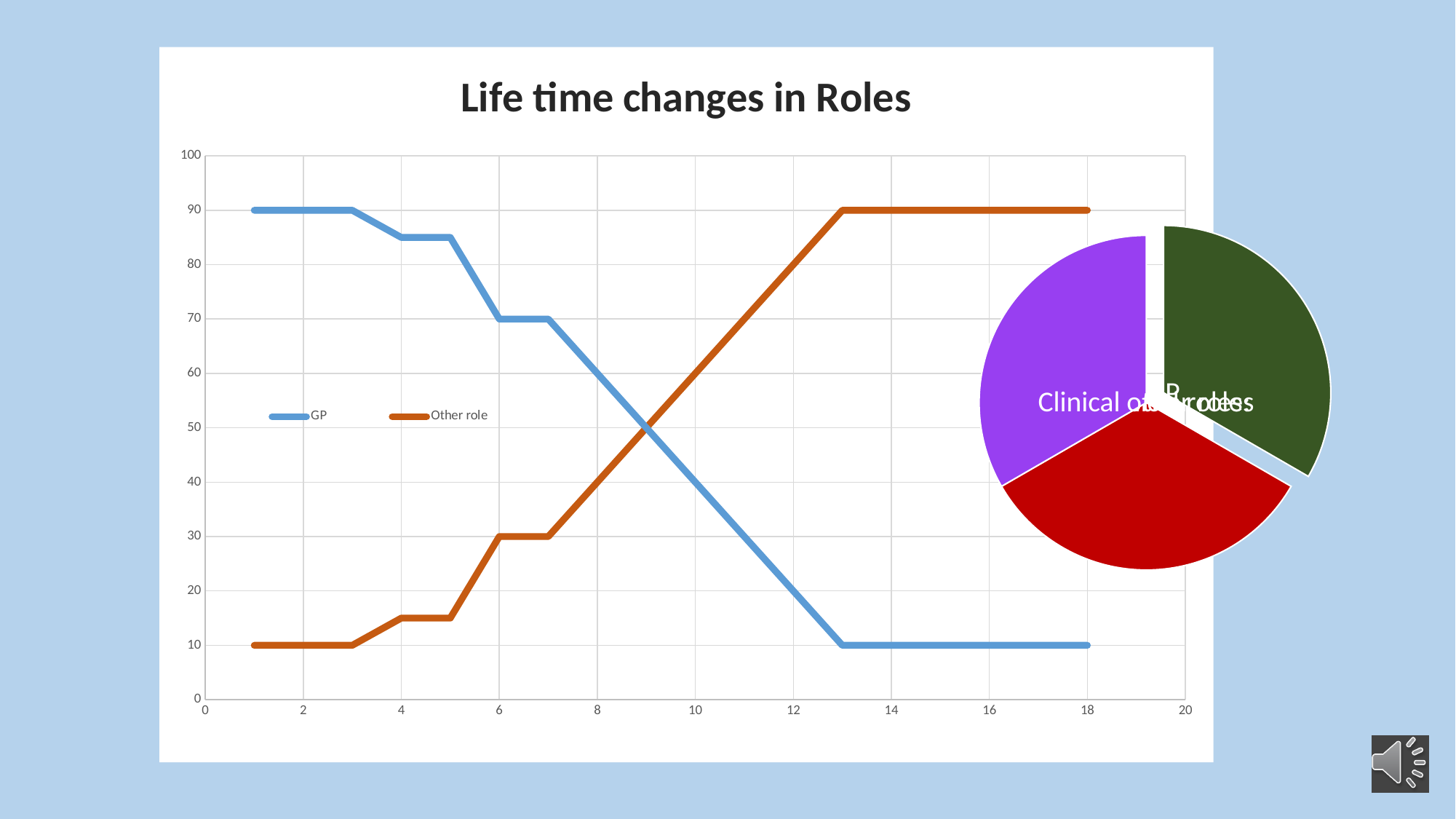
In the 'Life time changes in Roles' chart, what is the value of the GP series at x = 1? 90 In the 'Life time changes in Roles' chart, how many series does the legend list? 2 In the 'Life time changes in Roles' chart, what is the value of the GP series at x = 18? 10 In the 'Life time changes in Roles' chart, at x = 12, which series has the higher value, GP or Other role? Other role In the 'Life time changes in Roles' chart, what is the value of the Other role series at x = 1? 10 What kind of chart is the 'Life time changes in Roles' chart on the left of the slide? line chart In the 'Life time changes in Roles' chart, is the GP value at x = 10 greater or less than 50? less In the 'Life time changes in Roles' chart, does the GP series rise or fall as x increases? fall What is the title of the line chart on the slide? Life time changes in Roles In the 'Life time changes in Roles' chart, what is the value of the Other role series at x = 13? 90 In the 'Life time changes in Roles' chart, what are the two series named in the legend? GP and Other role In the 'Life time changes in Roles' chart, what is the difference between the GP value and the Other role value at x = 1? 80